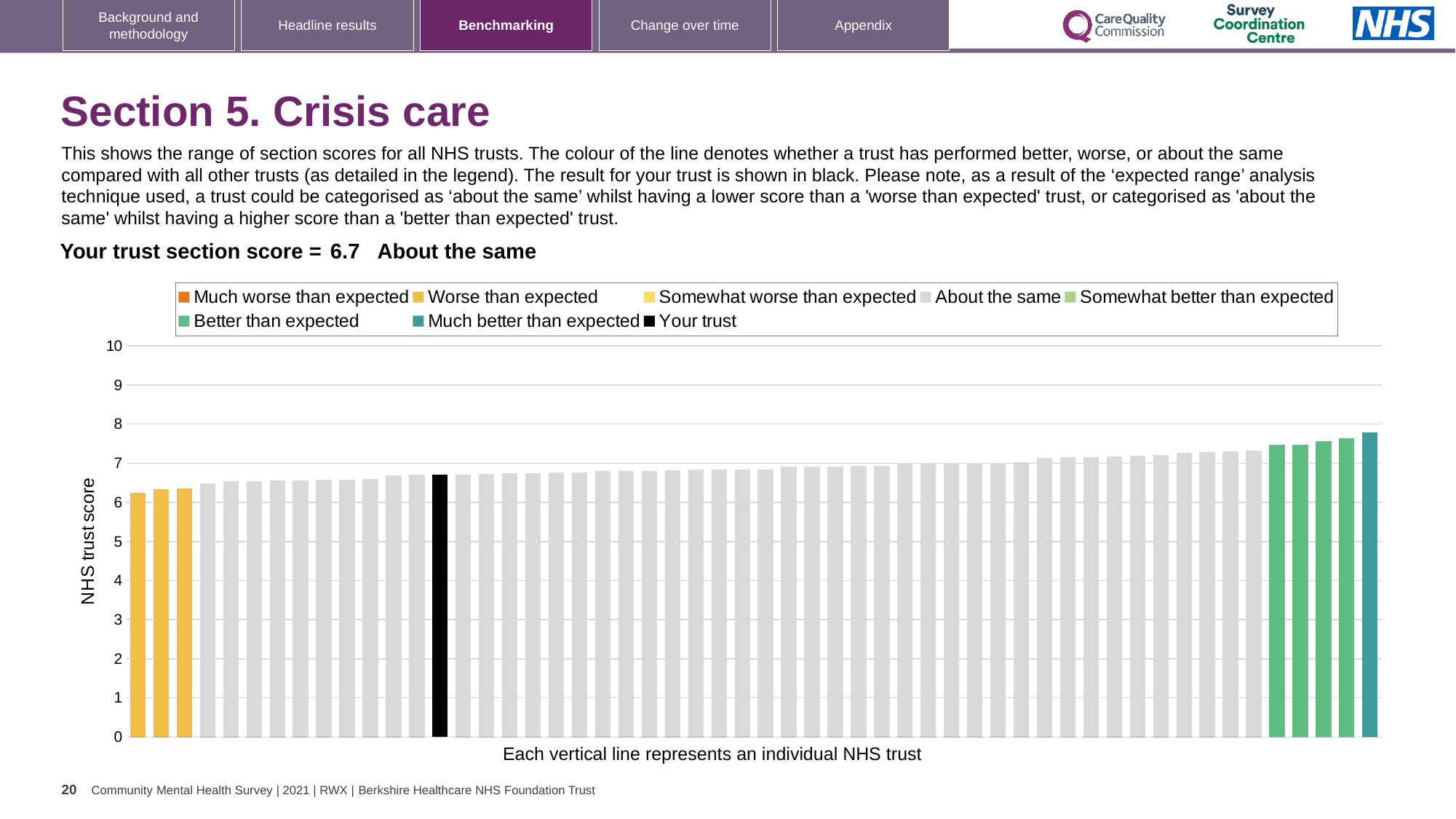
What is the label on the vertical axis of the chart? NHS trust score What kind of chart is shown on the slide? bar chart How many bars are coloured as 'Much better than expected' (teal)? 1 Is the value of the leftmost bar in the chart greater or less than 7? less What is the section score for your trust shown on the slide? 6.7 How is your trust's section score categorised on the slide? About the same How many bars are coloured as 'Worse than expected' (yellow)? 3 How many entries does the chart legend list? 8 Do the bar values rise or fall from left to right along the x axis? rise Which legend category does the tallest bar in the chart belong to? Much better than expected Is the value of the black bar (your trust) greater or less than 5? greater Is the value of the tallest bar in the chart greater or less than 7? greater